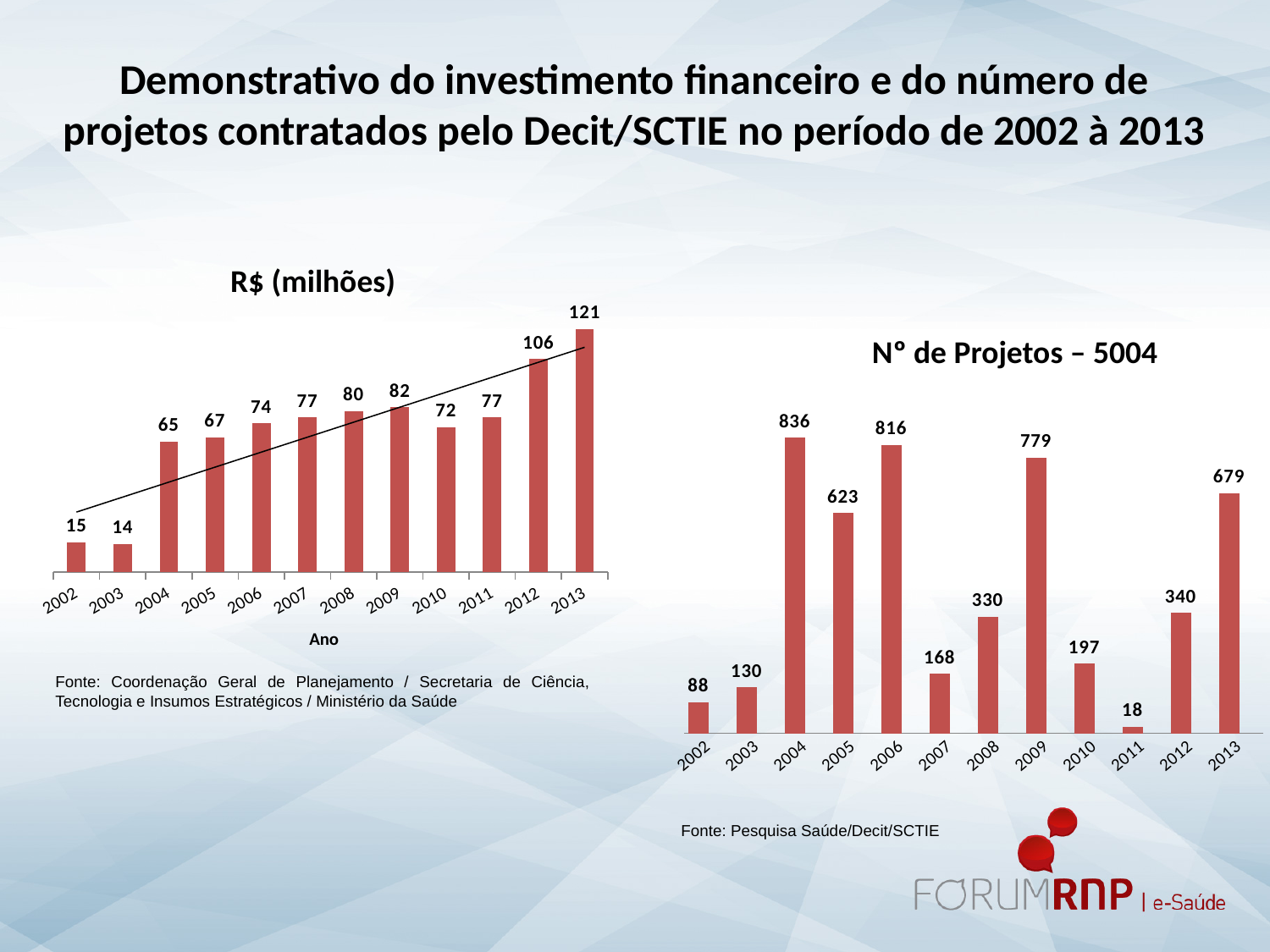
In the R$ (milhões) chart, what is the difference between the values for 2012 and 2011? 29 What total number of projects is stated in the title of the right-hand chart? 5004 In the Nº de Projetos chart, which year has the lowest value? 2011 In the R$ (milhões) chart, which year has the lowest value? 2003 In the Nº de Projetos chart, which is larger, the value for 2005 or the value for 2013? 2013 In the Nº de Projetos chart, what is the value for 2002? 88 In the R$ (milhões) chart, what kind of chart is shown? Bar chart In the Nº de Projetos chart, which year has the highest value? 2004 In the R$ (milhões) chart, how many years are shown on the x axis? 12 In the Nº de Projetos chart, what is the difference between the values for 2004 and 2006? 20 In the Nº de Projetos chart, what is the value for 2009? 779 In the R$ (milhões) chart, what is the value for 2013? 121